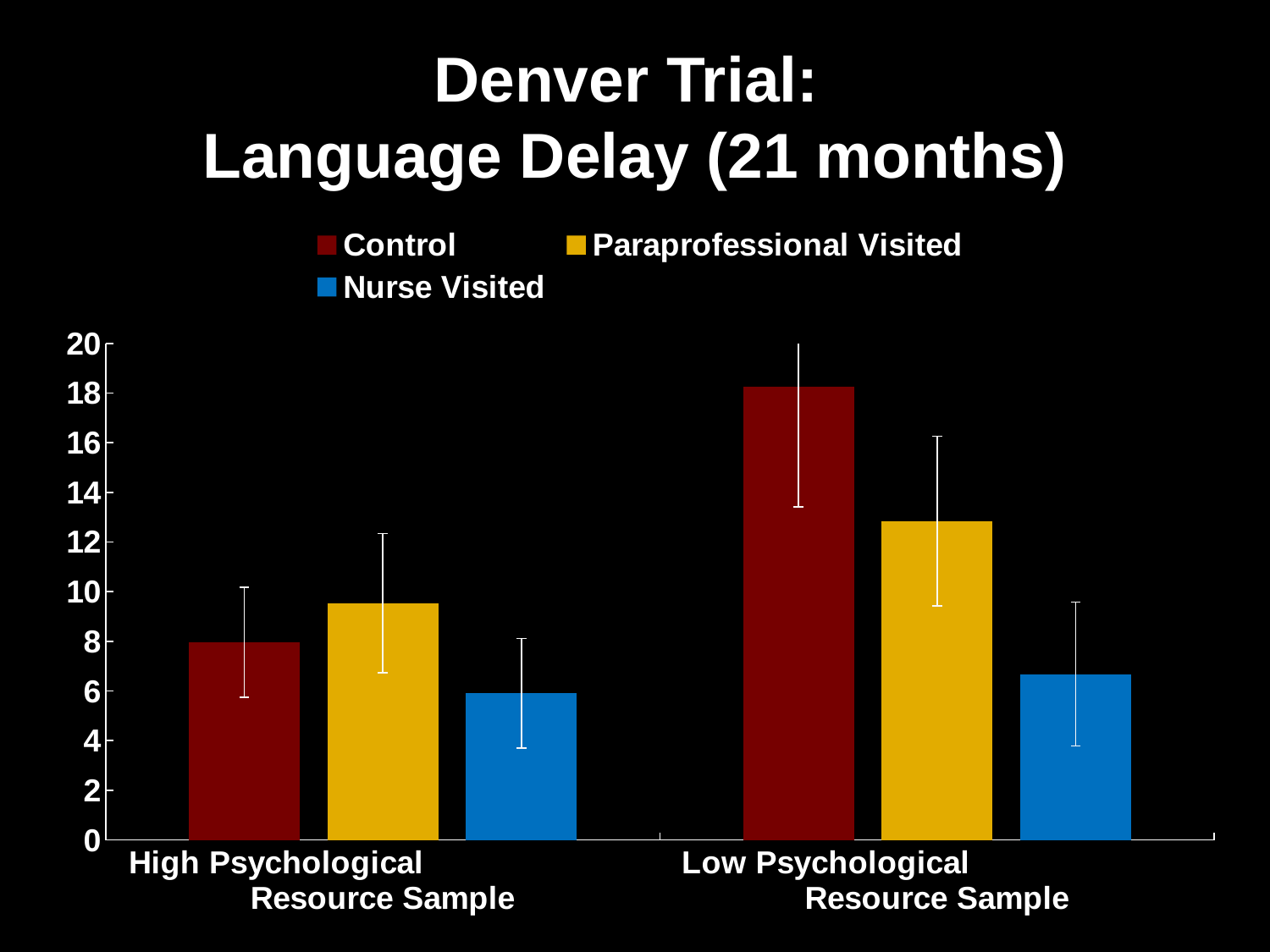
Is the Control value for the Low Psychological Resource Sample greater or less than 16? greater Is the Nurse Visited value for the High Psychological Resource Sample greater or less than 8? less Which series has the highest value in the Low Psychological Resource Sample? Control How many sample groups are shown on the x axis? 2 Is the Paraprofessional Visited value for the Low Psychological Resource Sample greater or less than 14? less How many series does the legend list? 3 Which series has the lowest value in the High Psychological Resource Sample? Nurse Visited What colour are the Nurse Visited bars? blue Which is larger: the Control value for the High Psychological Resource Sample or the Control value for the Low Psychological Resource Sample? Low Psychological Resource Sample Which is larger in the High Psychological Resource Sample: Paraprofessional Visited or Nurse Visited? Paraprofessional Visited Which series has the lowest value in the Low Psychological Resource Sample? Nurse Visited What kind of chart is shown on the slide? bar chart